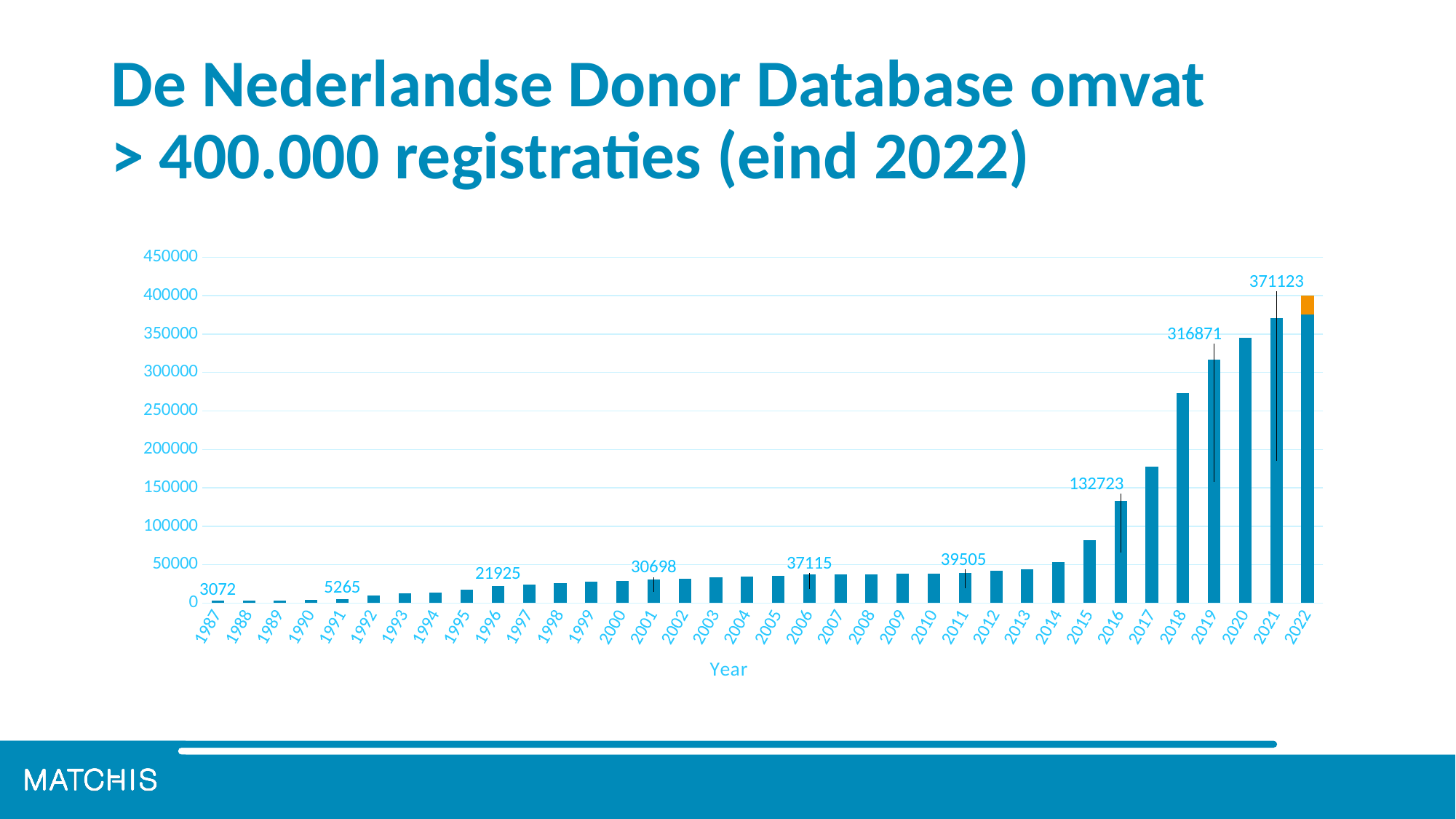
What is the value for 2019? 316871 What is the value for 1987? 3072 How many years are shown on the x axis? 36 Which year has the highest bar? 2022 What kind of chart is shown on the slide? bar chart What is the value for 2021? 371123 Which is larger, the value for 2011 or the value for 2006? 2011 What is the difference between the values for 1991 and 1987? 2193 Is the value for 2018 greater or less than 250000? greater What is the value for 2016? 132723 What is the difference between the values for 2021 and 2016? 238400 Is the value for 2017 greater or less than 200000? less